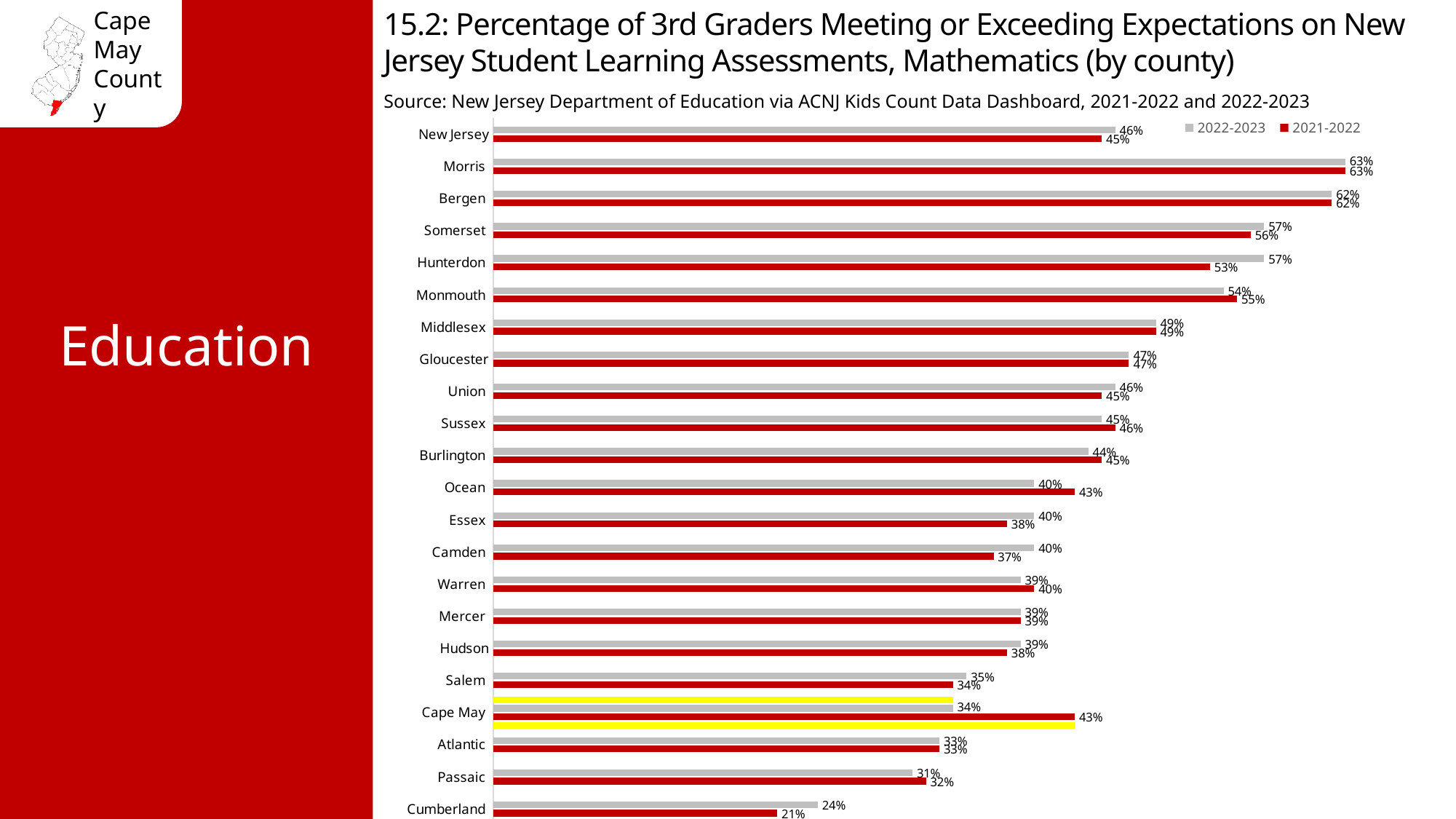
Which county has the highest 2022-2023 value? Morris What is the difference between Cape May's 2021-2022 value and its 2022-2023 value? 9% Which is larger for Ocean: the 2022-2023 value or the 2021-2022 value? 2021-2022 What is the 2022-2023 value for Hunterdon? 57% What is the 2022-2023 value for Cape May? 34% What is the 2021-2022 value for Cumberland? 21% What is the 2021-2022 value for Cape May? 43% How many series does the legend list? 2 Which county has the lowest 2021-2022 value? Cumberland Which colour represents the 2021-2022 series in the legend? red How many categories (counties plus New Jersey) are shown on the chart? 22 What kind of chart is shown on the slide? bar chart